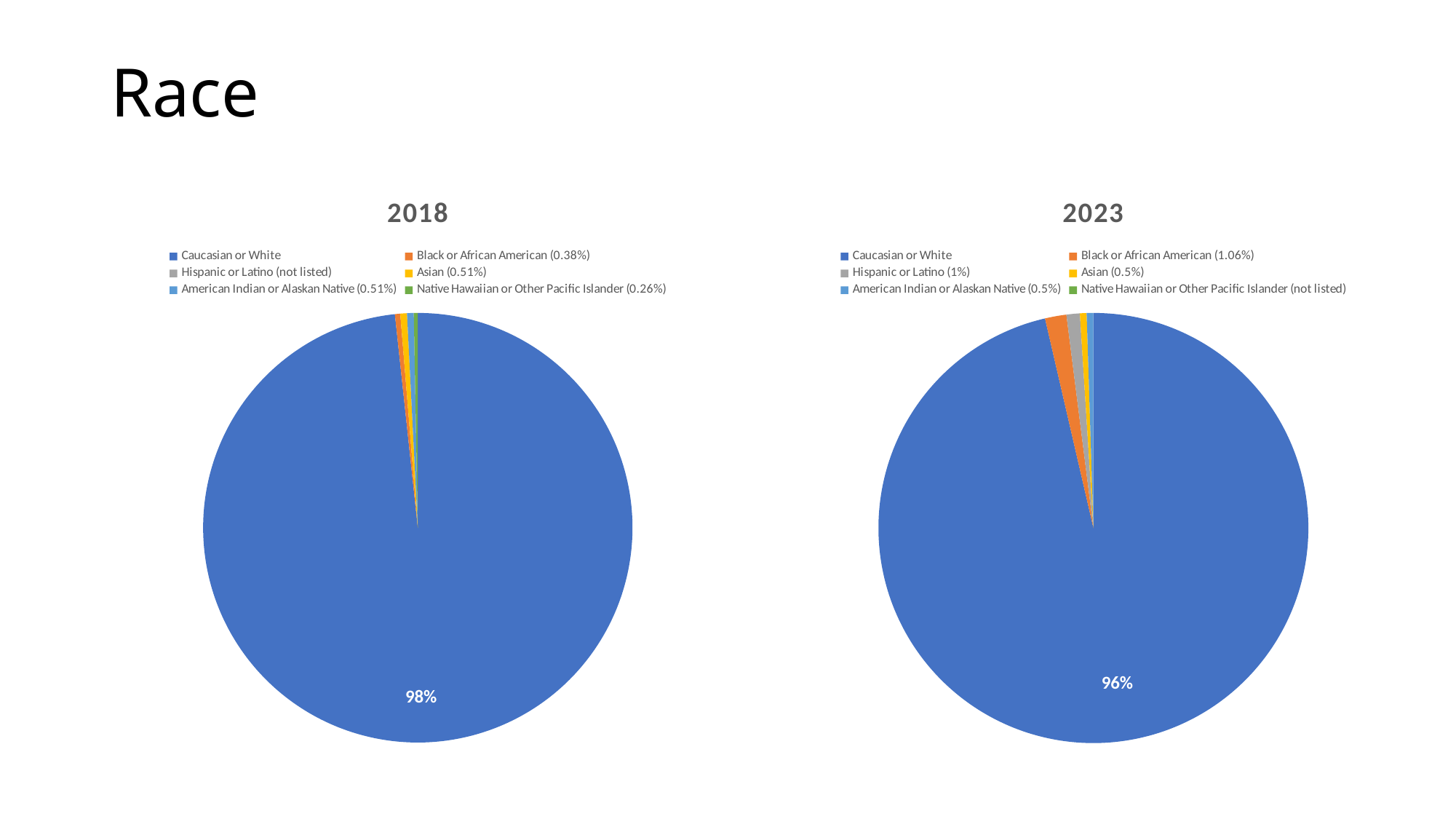
In the 2018 chart, which category is the largest slice? Caucasian or White In the 2018 chart, what percentage is given in the legend for Native Hawaiian or Other Pacific Islander? 0.26% In the 2018 chart, what percentage is given in the legend for Black or African American? 0.38% In the 2023 chart, what percentage is given in the legend for Hispanic or Latino? 1% What is the difference between the Caucasian or White share in the 2018 chart and in the 2023 chart? 2% Is the Caucasian or White share larger in the 2018 chart or the 2023 chart? 2018 What kind of chart is the 2018 chart? Pie chart In the 2023 chart, what share of the pie is Caucasian or White? 96% How many categories does the legend of the 2023 chart list? 6 In the 2018 chart, what share of the pie is Caucasian or White? 98% In the 2023 chart, which category is the largest slice? Caucasian or White In the 2023 chart, what percentage is given in the legend for Black or African American? 1.06%